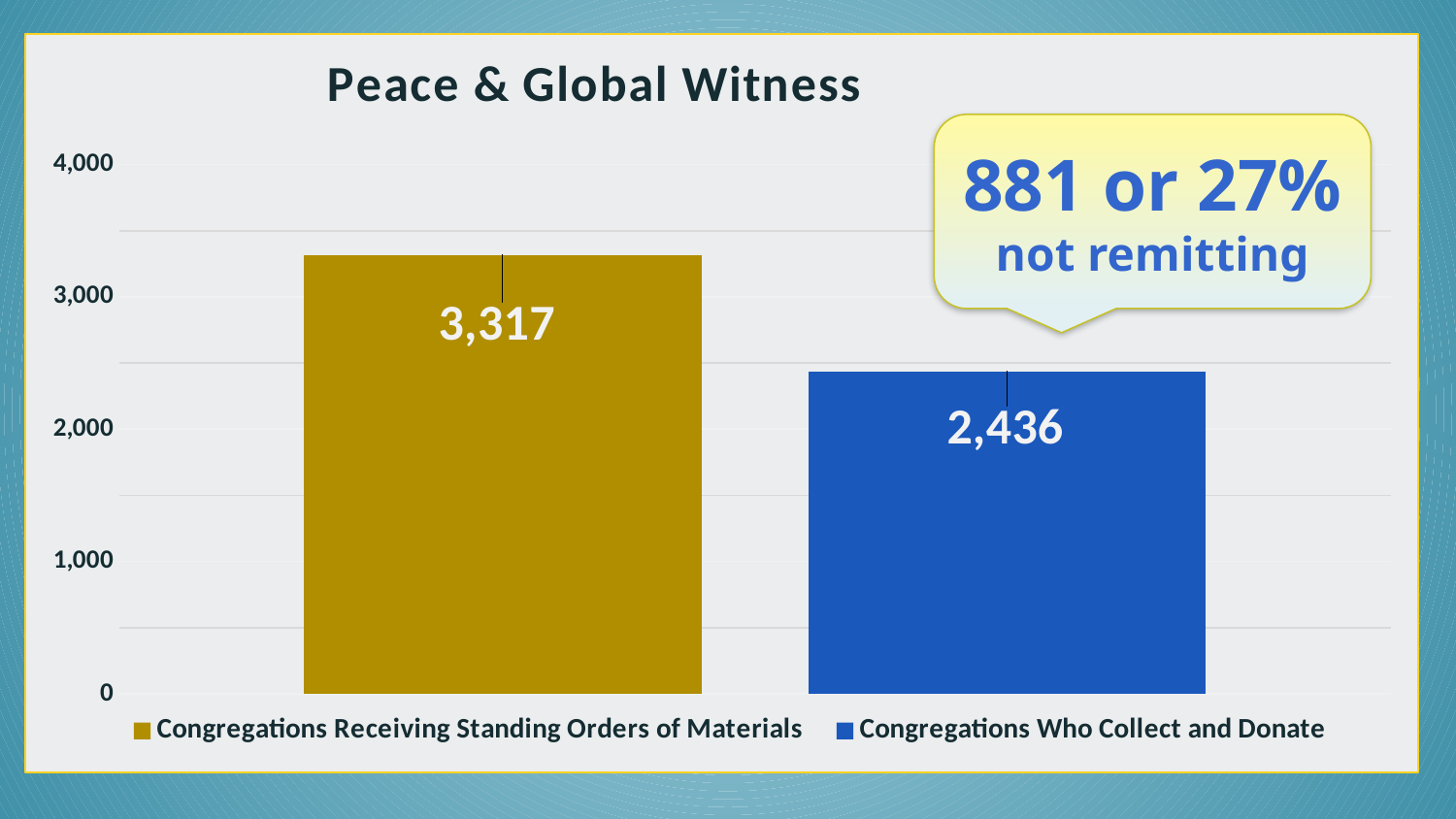
What is the title of the chart? Peace & Global Witness What is the difference between Congregations Receiving Standing Orders of Materials and Congregations Who Collect and Donate? 881 Is the value for Congregations Receiving Standing Orders of Materials greater or less than 3,000? greater How many series does the legend list? 2 Which series has the higher value? Congregations Receiving Standing Orders of Materials What kind of chart is shown on the slide? bar chart Which series has the lower value? Congregations Who Collect and Donate What is the highest value shown on the vertical axis? 4,000 Is the value for Congregations Who Collect and Donate greater or less than 3,000? less What is the value for Congregations Receiving Standing Orders of Materials? 3,317 What is the value for Congregations Who Collect and Donate? 2,436 What colour is the bar for Congregations Who Collect and Donate? blue